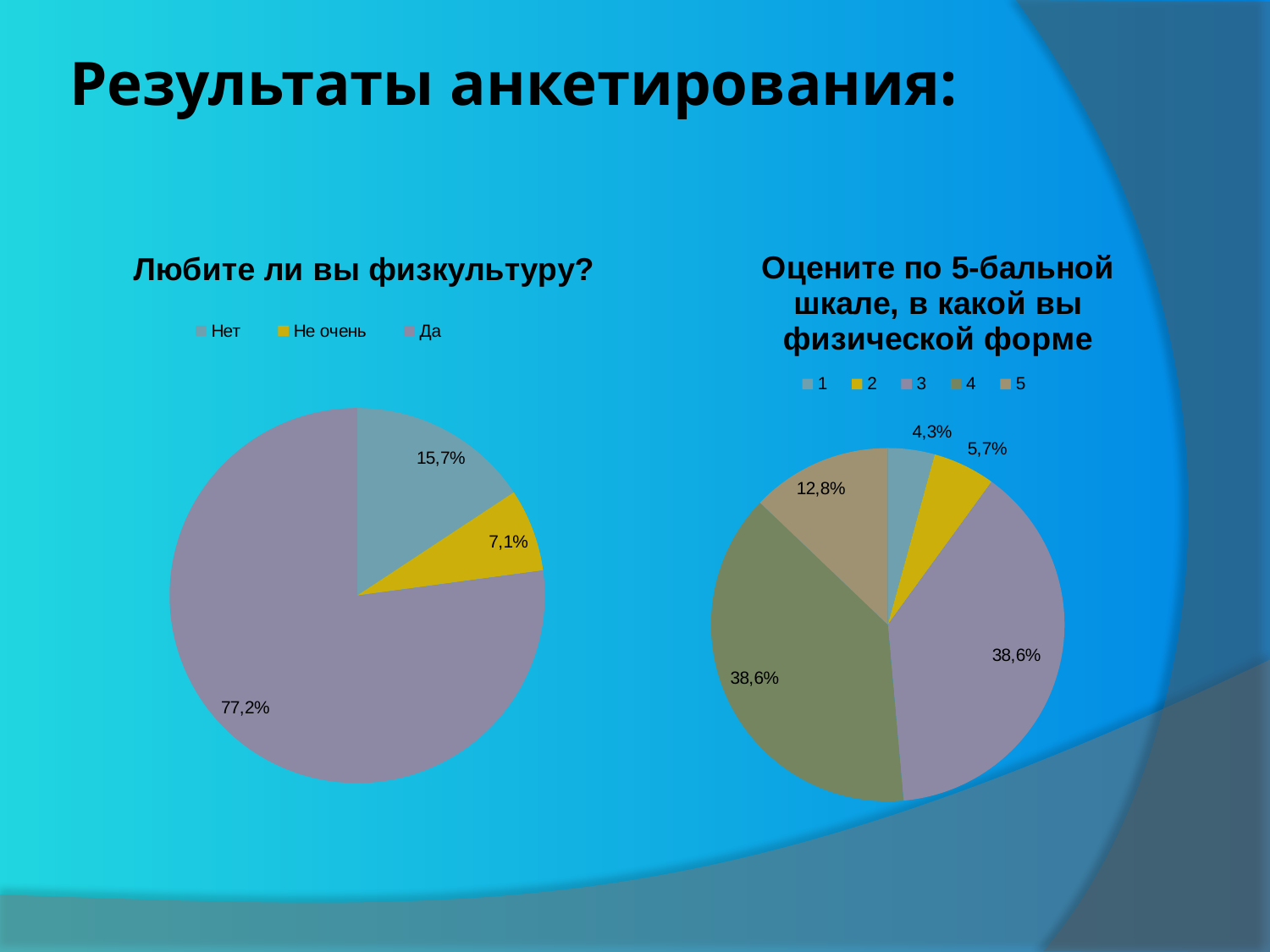
On the left chart 'Любите ли вы физкультуру?', what share of respondents answered 'Не очень'? 7,1% On the right chart 'Оцените по 5-бальной шкале, в какой вы физической форме', what share of respondents rated themselves 1? 4,3% On the left chart 'Любите ли вы физкультуру?', which answer has the smallest share? Не очень On the left chart 'Любите ли вы физкультуру?', which answer has the largest share? Да On the left chart 'Любите ли вы физкультуру?', what is the difference between the shares for 'Нет' and 'Не очень'? 8,6% On the right chart 'Оцените по 5-бальной шкале, в какой вы физической форме', what share of respondents rated themselves 5? 12,8% On the left chart 'Любите ли вы физкультуру?', what share of respondents answered 'Да'? 77,2% On the right chart 'Оцените по 5-бальной шкале, в какой вы физической форме', which is larger: the share for rating 2 or the share for rating 5? 5 On the left chart 'Любите ли вы физкультуру?', how many answer categories are shown in the legend? 3 What kind of chart is the right chart 'Оцените по 5-бальной шкале, в какой вы физической форме'? Pie chart On the right chart 'Оцените по 5-бальной шкале, в какой вы физической форме', which rating has the smallest share? 1 On the left chart 'Любите ли вы физкультуру?', what share of respondents answered 'Нет'? 15,7%